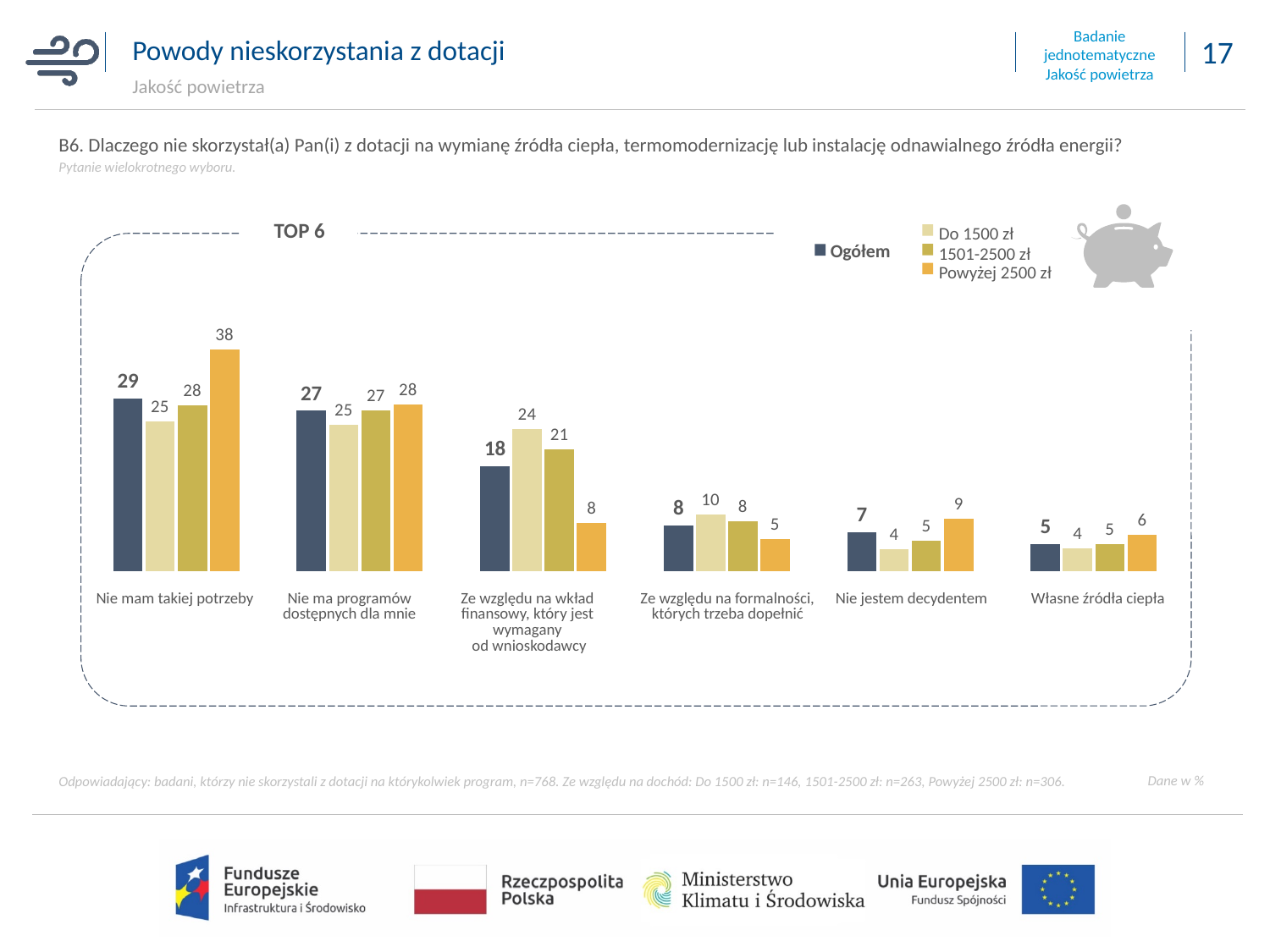
Which category has the lowest Ogółem value? Własne źródła ciepła How many series does the legend list? 4 What is the value for "Do 1500 zł" in the category "Ze względu na wkład finansowy, który jest wymagany od wnioskodawcy"? 24 Do the Ogółem values rise or fall from left to right across the categories? Fall How many categories are shown on the chart? 6 What is the Ogółem value for "Nie mam takiej potrzeby"? 29 Which category has the highest Ogółem value? Nie mam takiej potrzeby For "Ze względu na wkład finansowy, który jest wymagany od wnioskodawcy", which is larger: the value for "Do 1500 zł" or for "Powyżej 2500 zł"? Do 1500 zł What is the value for "Powyżej 2500 zł" in the category "Nie mam takiej potrzeby"? 38 What kind of chart is shown on the slide? Bar chart What is the Ogółem value for "Nie jestem decydentem"? 7 What is the difference between the "Powyżej 2500 zł" value and the "Do 1500 zł" value for "Nie mam takiej potrzeby"? 13